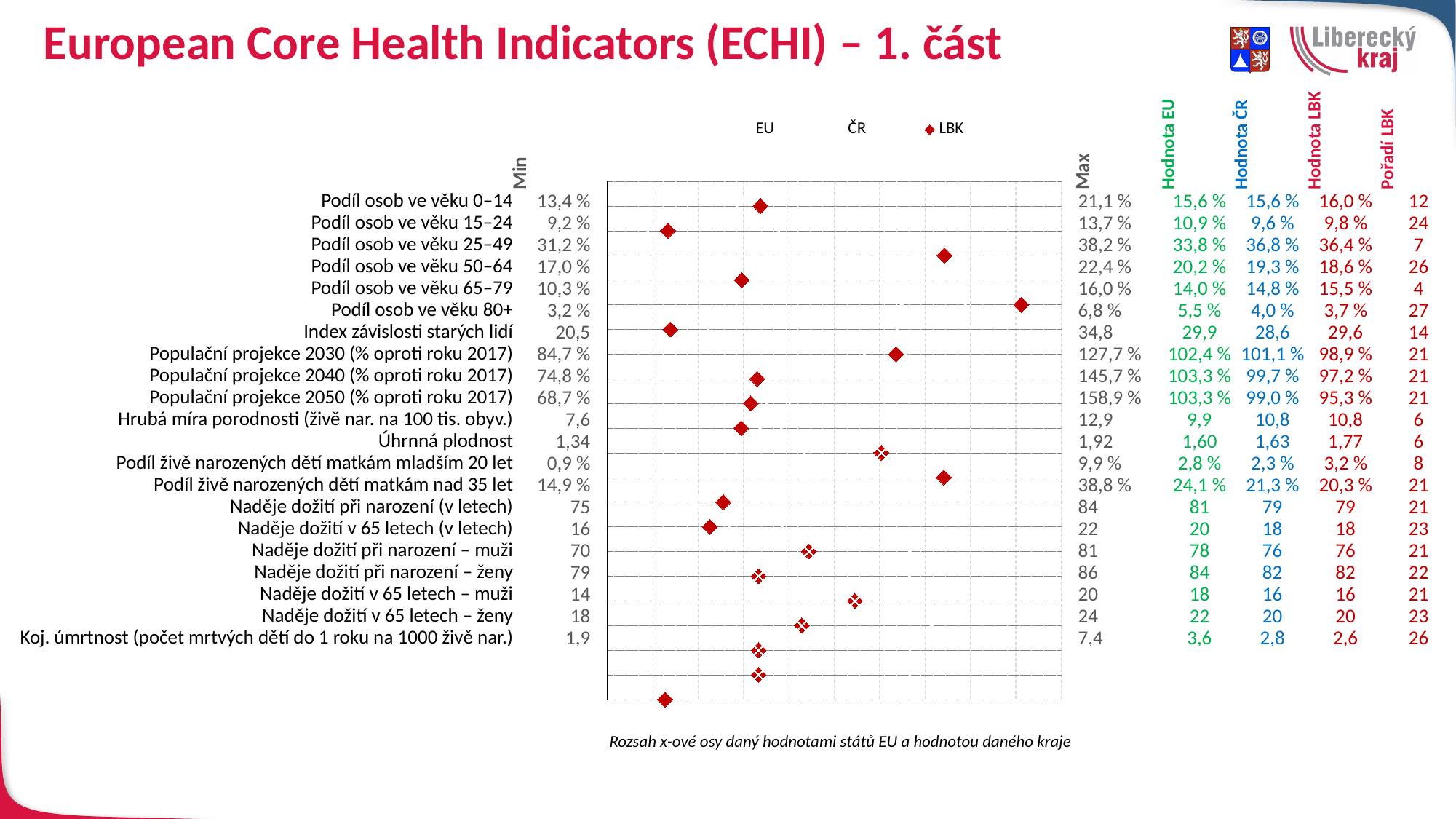
How many series does the chart legend list? 3 What kind of chart is shown on the slide? scatter chart What are the series names in the chart legend? EU, ČR, LBK How many indicators are listed on the left of the chart? 21 What is the Pořadí LBK for Podíl osob ve věku 65–79? 4 What is the difference between the Max and Min values for Podíl osob ve věku 0–14? 7,7 % Which is larger for Podíl osob ve věku 25–49, Hodnota ČR or Hodnota LBK? Hodnota ČR Which indicator has the highest Pořadí LBK? Podíl osob ve věku 80+ What is the Max value for Populační projekce 2050 (% oproti roku 2017)? 158,9 % What is the Min value for Úhrnná plodnost? 1,34 What is the Hodnota EU value for Koj. úmrtnost (počet mrtvých dětí do 1 roku na 1000 živě nar.)? 3,6 What is the Hodnota LBK value for Podíl osob ve věku 80+? 3,7 %